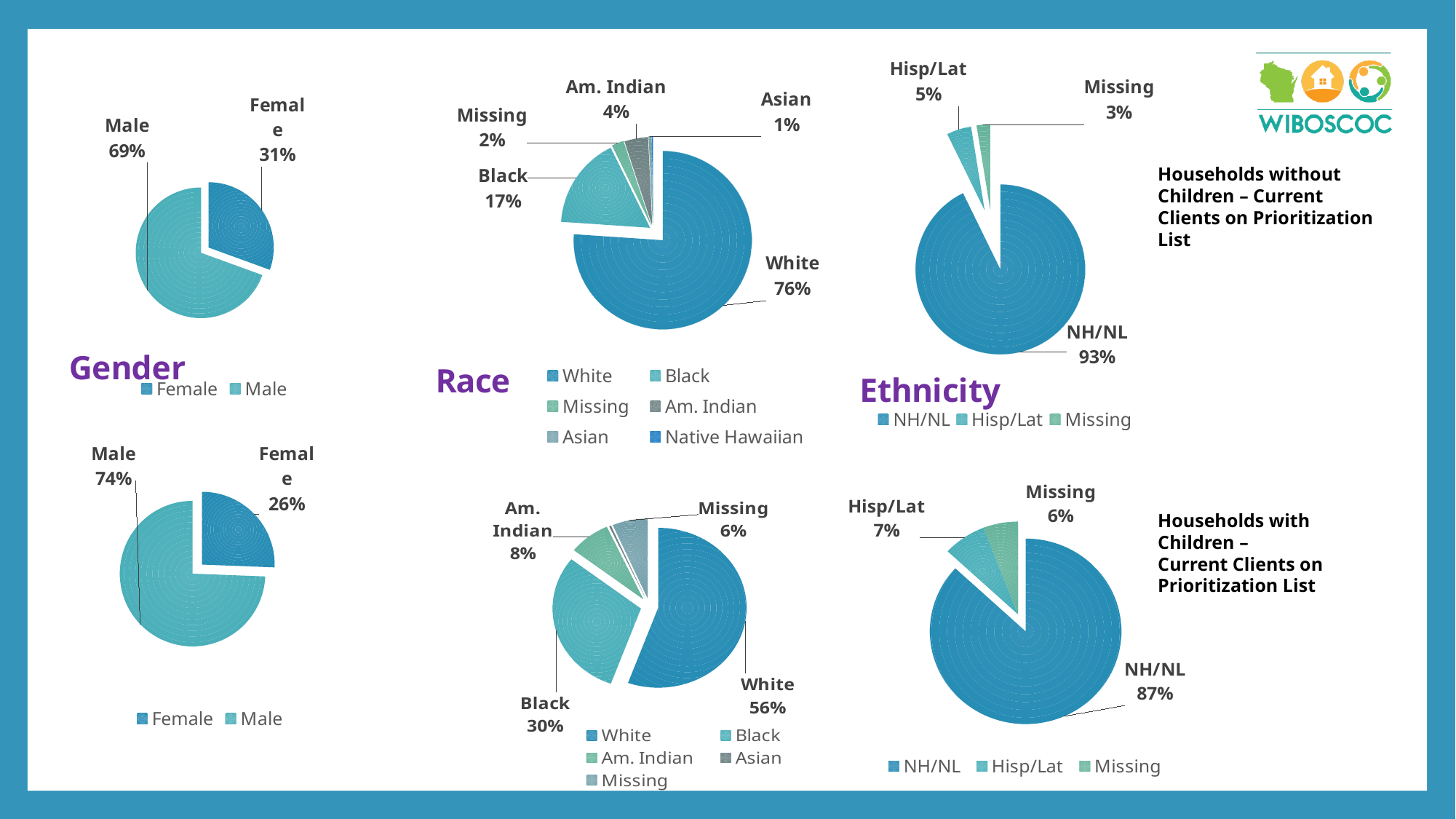
In the bottom Race pie chart (Households with Children), what is the difference between the White and Black shares? 26% How many entries does the legend of the top Race pie chart (Households without Children) list? 6 What type of chart is used for Gender on this slide? Pie chart In the bottom-right Ethnicity pie chart (Households with Children), which is larger, Hisp/Lat or Missing? Hisp/Lat In the bottom-right Ethnicity pie chart (Households with Children), what percentage is Missing? 6% In the top Race pie chart (Households without Children), which category has the smallest labelled share? Asian In the bottom-left Gender pie chart (Households with Children), what share is Female? 26% In the bottom Race pie chart (Households with Children), what percentage is White? 56% In the top Race pie chart (Households without Children), what percentage is Black? 17% In the top-left Gender pie chart (Households without Children), what is the difference between the Male and Female shares? 38% In the top-right Ethnicity pie chart (Households without Children), what share is NH/NL? 93% In the top-left Gender pie chart (Households without Children), what share is Male? 69%